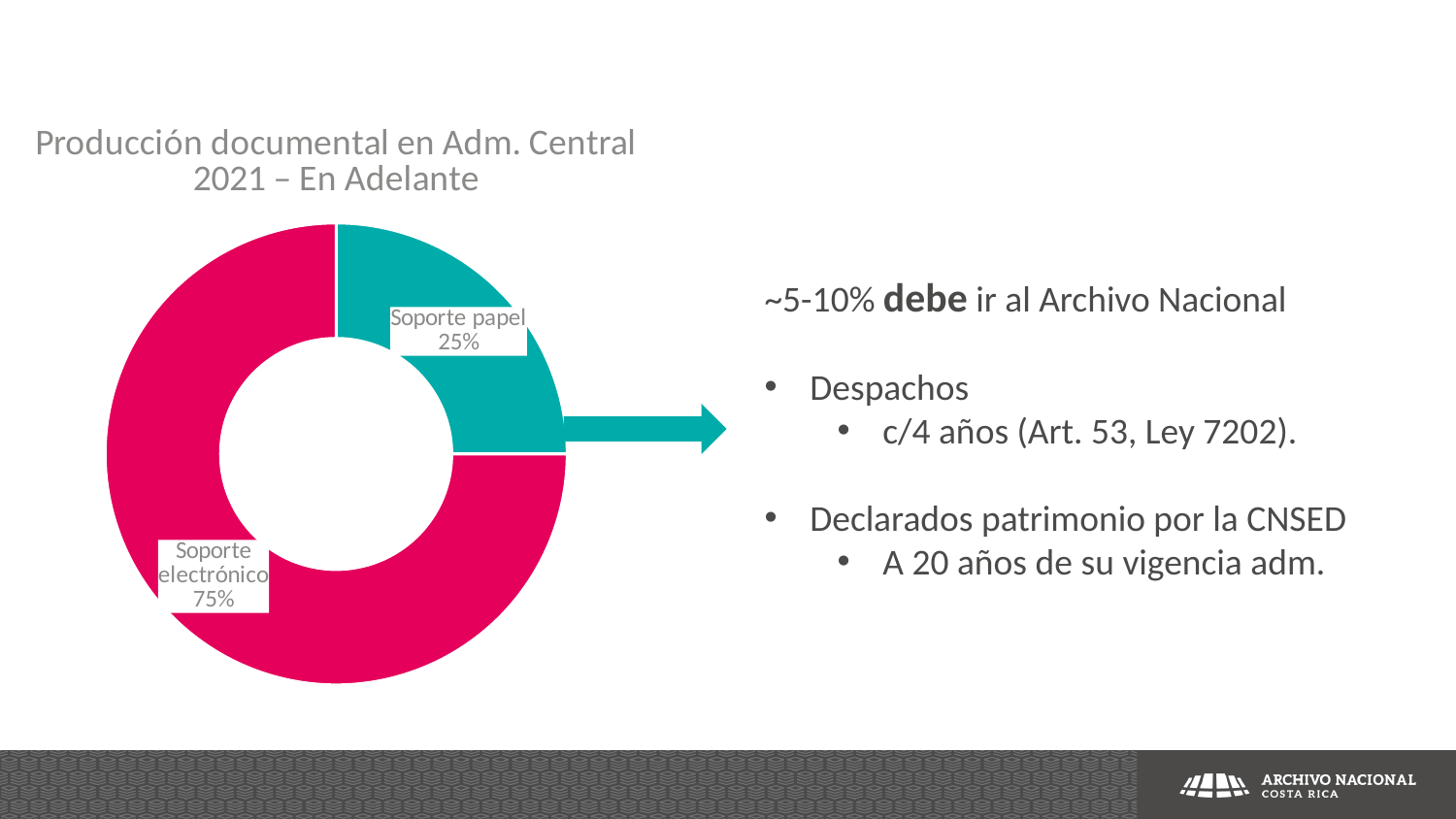
Which is larger, Soporte papel or Soporte electrónico? Soporte electrónico What colour is the Soporte papel slice? Teal Which category has the largest share in the chart? Soporte electrónico What is the title of the chart? Producción documental en Adm. Central 2021 – En Adelante How many categories are shown in the chart? 2 What share of the chart does Soporte electrónico represent? 75% What share of the chart does Soporte papel represent? 25% What kind of chart is shown on the slide? Doughnut chart What is the difference in percentage points between Soporte electrónico and Soporte papel? 50 Which category has the smallest share in the chart? Soporte papel